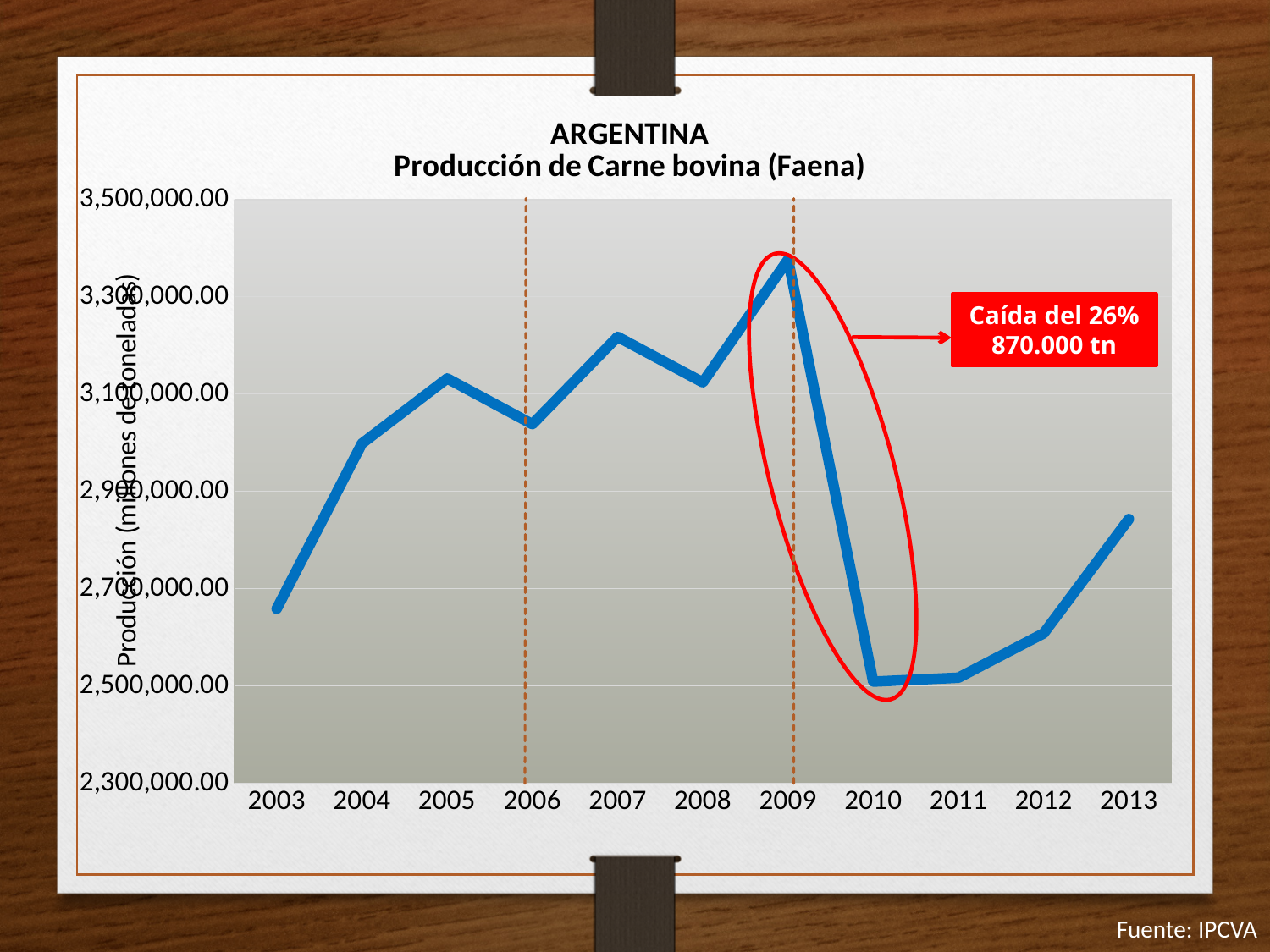
Does production rise or fall from 2011 to 2013? rise Is the value for 2013 greater or less than 2,900,000.00? less Is the value for 2007 greater or less than 3,100,000.00? greater Is the value for 2003 greater or less than 2,700,000.00? less What kind of chart is shown on the slide? line chart What percentage drop does the red annotation box on the chart state? 26% Which year has the larger production value, 2009 or 2010? 2009 How many years are plotted along the x axis? 11 Which year has the highest production value? 2009 Which year has the larger production value, 2003 or 2004? 2004 Does production rise or fall from 2009 to 2010? fall